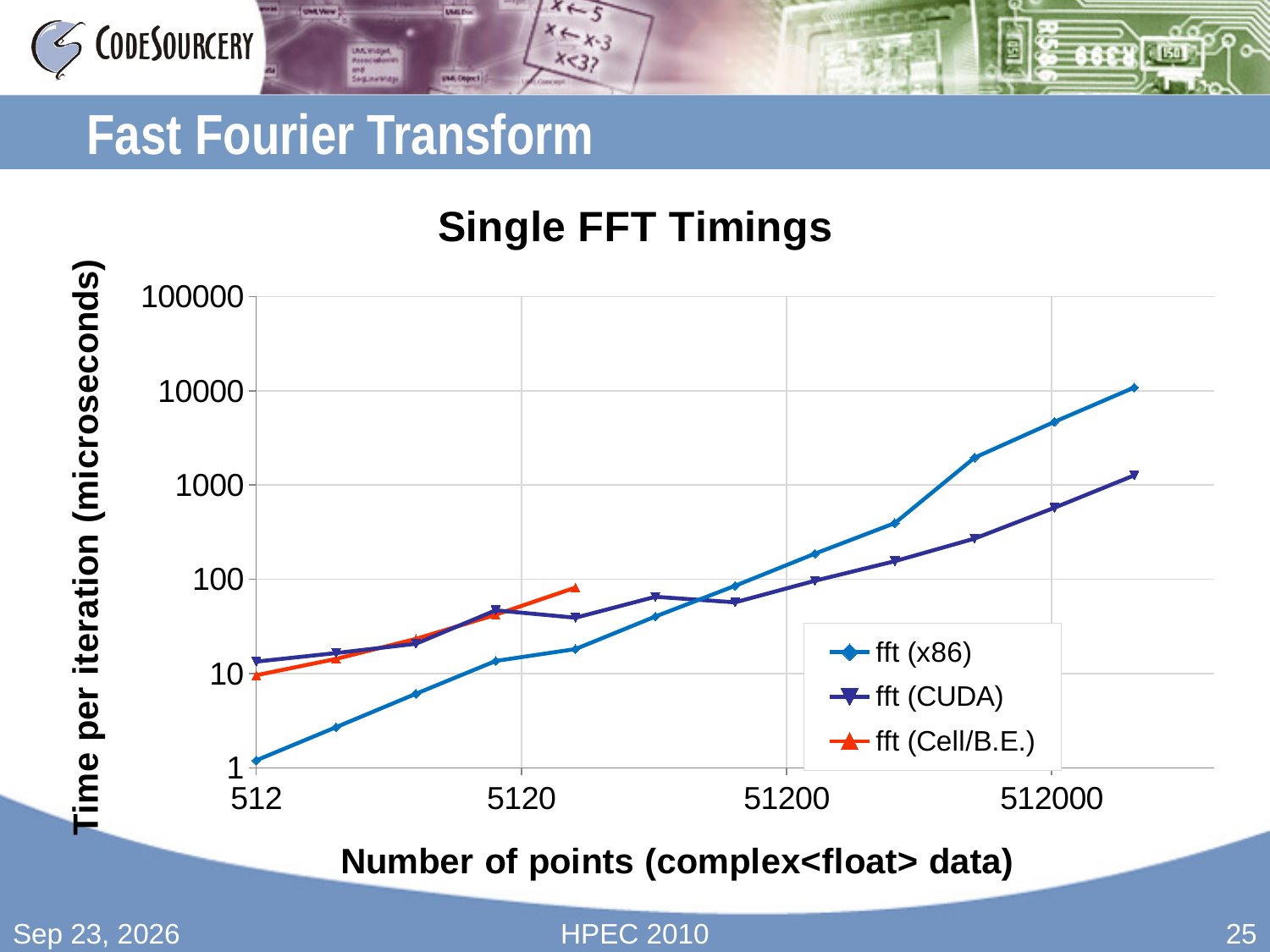
What is the label of the y axis? Time per iteration (microseconds) How many data points are plotted for the fft (Cell/B.E.) series? 5 Is the value for fft (CUDA) at 512000 points greater or less than 1000? less At 512000 points, which is larger: the value for fft (x86) or fft (CUDA)? fft (x86) Is the value for fft (x86) at 512 points greater or less than 10? less How many series does the legend list? 3 Does the fft (x86) series rise or fall as the number of points increases? rises What kind of chart is shown on the slide? line chart At 512 points, which is larger: the value for fft (CUDA) or fft (x86)? fft (CUDA) Which series reaches the highest time per iteration on the chart? fft (x86) Which series has the lowest time per iteration at 512 points? fft (x86) What is the title of the chart? Single FFT Timings